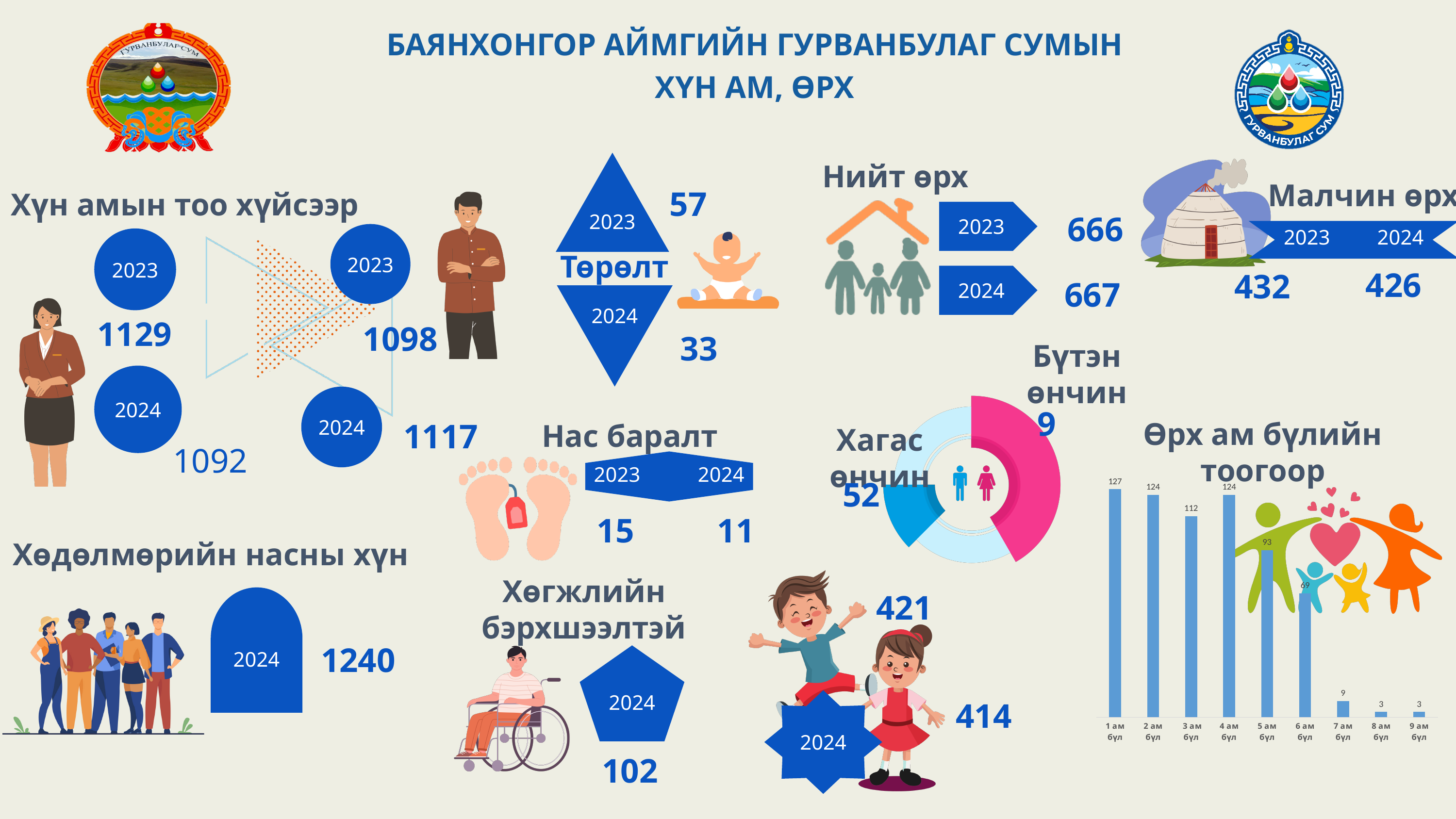
In the 'Өрх ам бүлийн тоогоор' bar chart, what value is shown for both '8 ам бүл' and '9 ам бүл'? 3 What kind of chart is 'Өрх ам бүлийн тоогоор'? bar chart In the 'Өрх ам бүлийн тоогоор' bar chart, do the values generally rise or fall from '4 ам бүл' to '9 ам бүл'? fall In the 'Өрх ам бүлийн тоогоор' bar chart, what is the difference between the values for '5 ам бүл' and '6 ам бүл'? 24 In the 'Өрх ам бүлийн тоогоор' bar chart, what is the value for '1 ам бүл'? 127 How many categories does the 'Өрх ам бүлийн тоогоор' bar chart show? 9 In the 'Өрх ам бүлийн тоогоор' bar chart, what is the difference between the values for '1 ам бүл' and '3 ам бүл'? 15 In the 'Өрх ам бүлийн тоогоор' bar chart, which is larger: the value for '3 ам бүл' or '4 ам бүл'? 4 ам бүл In the 'Өрх ам бүлийн тоогоор' bar chart, what is the value for '6 ам бүл'? 69 In the 'Өрх ам бүлийн тоогоор' bar chart, what is the value for '7 ам бүл'? 9 In the 'Өрх ам бүлийн тоогоор' bar chart, which category has the highest value? 1 ам бүл In the 'Өрх ам бүлийн тоогоор' bar chart, what is the value for '5 ам бүл'? 93